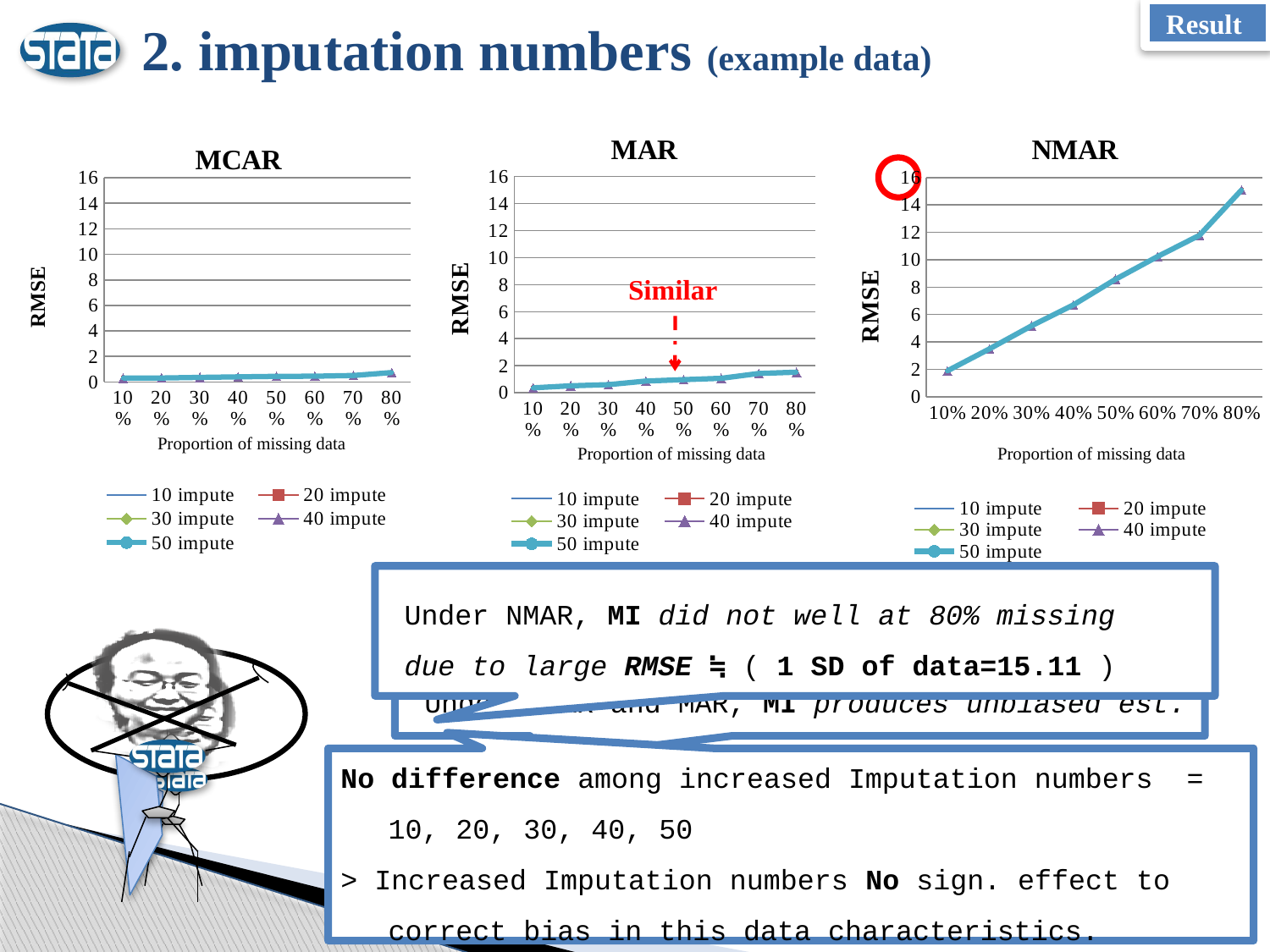
What is the label on the y axis of the MAR chart? RMSE In the NMAR chart, do the RMSE values rise or fall as the proportion of missing data increases from 10% to 80%? rise In the NMAR chart, is the RMSE value at 10% missing data greater or less than 4? less How many series does the legend of the NMAR chart list? 5 In the NMAR chart, which proportion of missing data has the highest RMSE? 80% How many proportion-of-missing-data points are plotted along the x axis of the MAR chart? 8 In the NMAR chart, which proportion of missing data has the lowest RMSE? 10% In the MCAR chart, is the RMSE value at 80% missing data greater or less than 2? less In the NMAR chart, which has the larger RMSE: 30% missing data or 70% missing data? 70% What kind of chart is the MCAR chart? line chart In the MAR chart, is the RMSE value at 80% missing data greater or less than 4? less